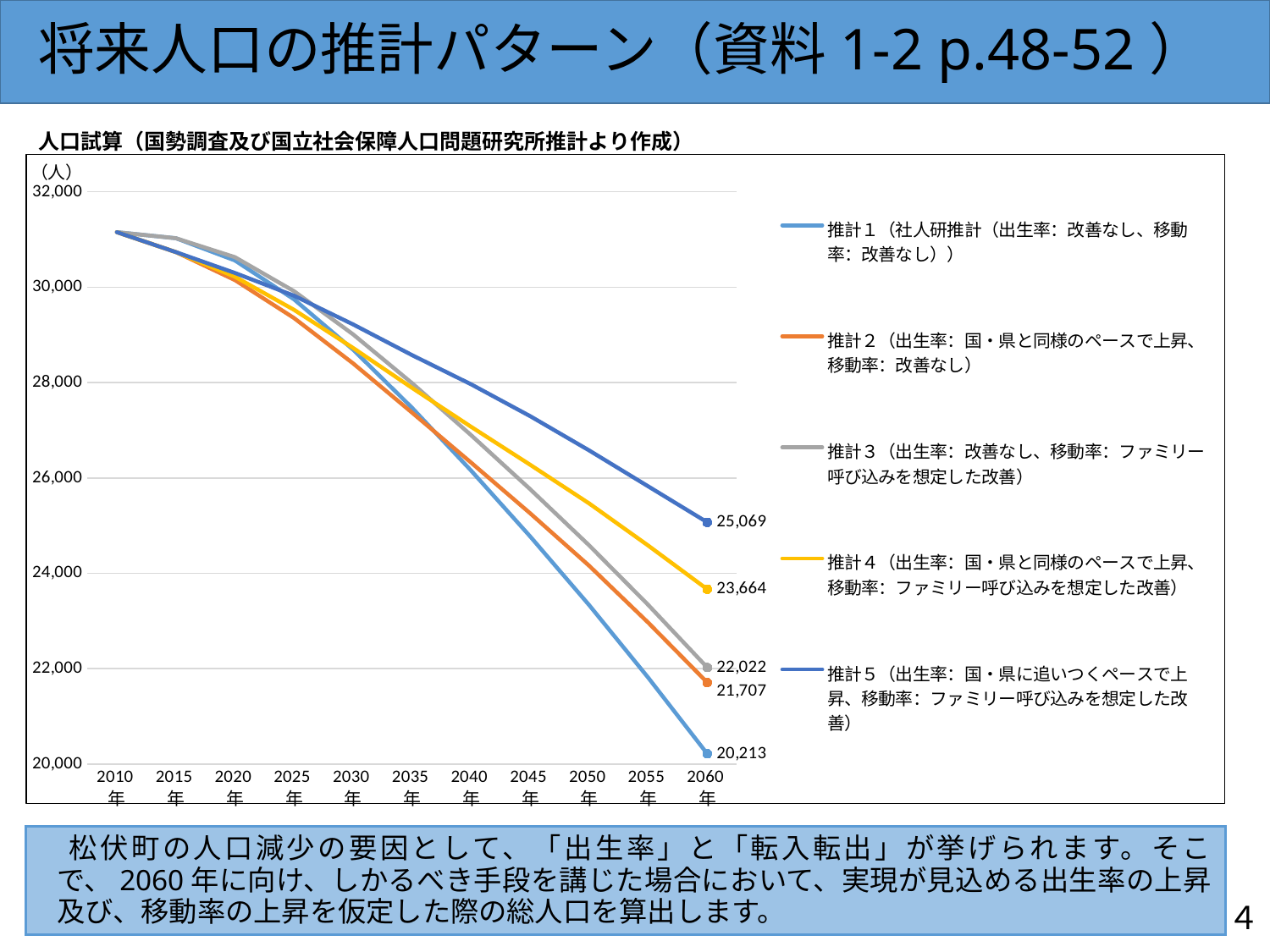
What is the value for 推計3 in 2060年? 22,022 What is the difference between the 2060年 values of 推計5 and 推計1? 4,856 How many series does the legend list? 5 Which series has the lowest value in 2060年? 推計1 What is the value for 推計4 in 2060年? 23,664 How many years are shown on the x axis? 11 Do the values rise or fall from 2010年 to 2060年? fall What is the value for 推計2 in 2060年? 21,707 What is the value for 推計5 in 2060年? 25,069 Which series has the highest value in 2060年? 推計5 What kind of chart is shown on the slide? line chart What is the value for 推計1 in 2060年? 20,213